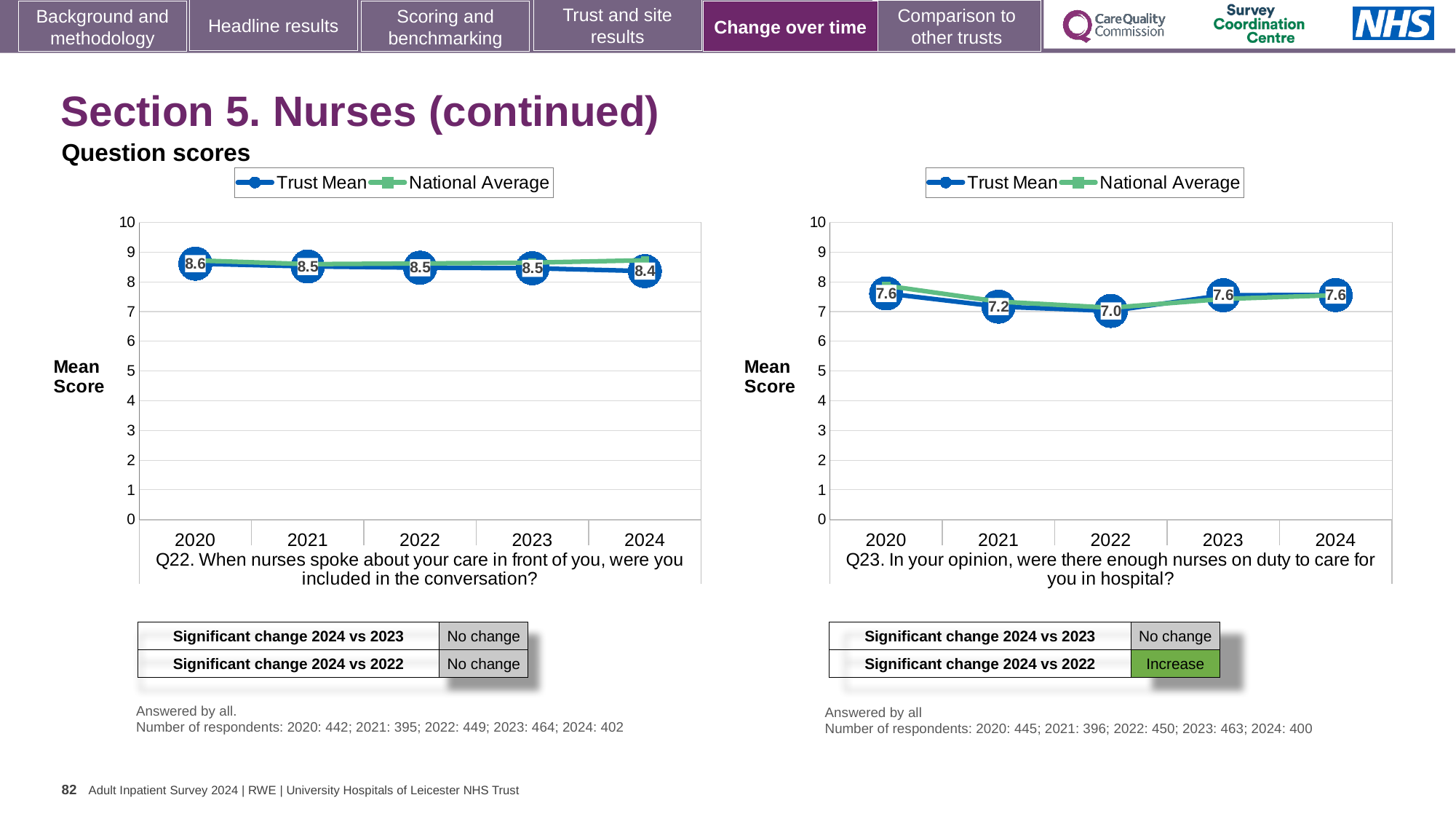
In the Q23 chart (right), what is the Trust Mean score for 2022? 7.0 In the Q23 chart (right), what is the difference between the Trust Mean score in 2024 and in 2022? 0.6 How many series does the legend of the Q23 chart (right) list? 2 How many years are plotted on the x axis of the Q22 chart (left)? 5 In the Q23 chart (right), which year has the lowest Trust Mean score? 2022 In the Q23 chart (right), what is the Trust Mean score for 2021? 7.2 In the Q23 chart (right), is the Trust Mean value for 2020 greater or less than 7? greater In the Q22 chart (left), which year has the highest Trust Mean score? 2020 What type of chart is the Q22 chart (left)? Line chart In the Q22 chart (left), is the Trust Mean score for 2021 larger or smaller than the Trust Mean score for 2024? larger In the Q22 chart (left), what is the Trust Mean score for 2020? 8.6 In the Q22 chart (left), what is the Trust Mean score for 2024? 8.4